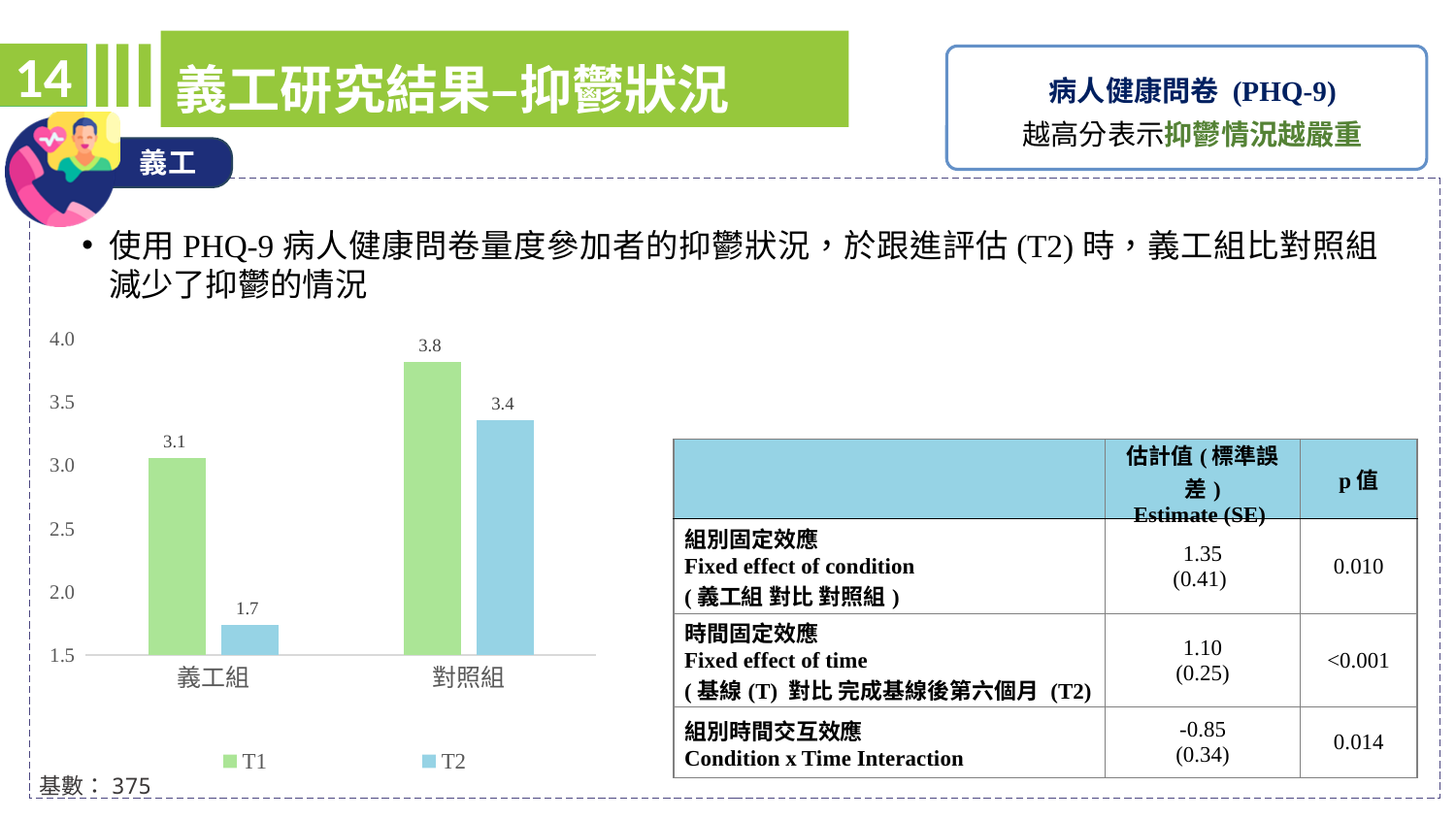
What is the difference between the T2 values of 對照組 and 義工組? 1.7 What is the T2 value for 對照組? 3.4 What is the difference between the T1 and T2 values for 義工組? 1.4 Which bar in the chart has the lowest value? 義工組 T2 How many groups (categories) are shown on the x axis of the chart? 2 What is the T1 value for 義工組? 3.1 What is the T1 value for 對照組? 3.8 Which group has the highest T1 value? 對照組 Which is larger, the T2 value for 義工組 or the T2 value for 對照組? 對照組 How many series does the chart legend list? 2 What is the T2 value for 義工組? 1.7 What type of chart is shown on the slide? Bar chart